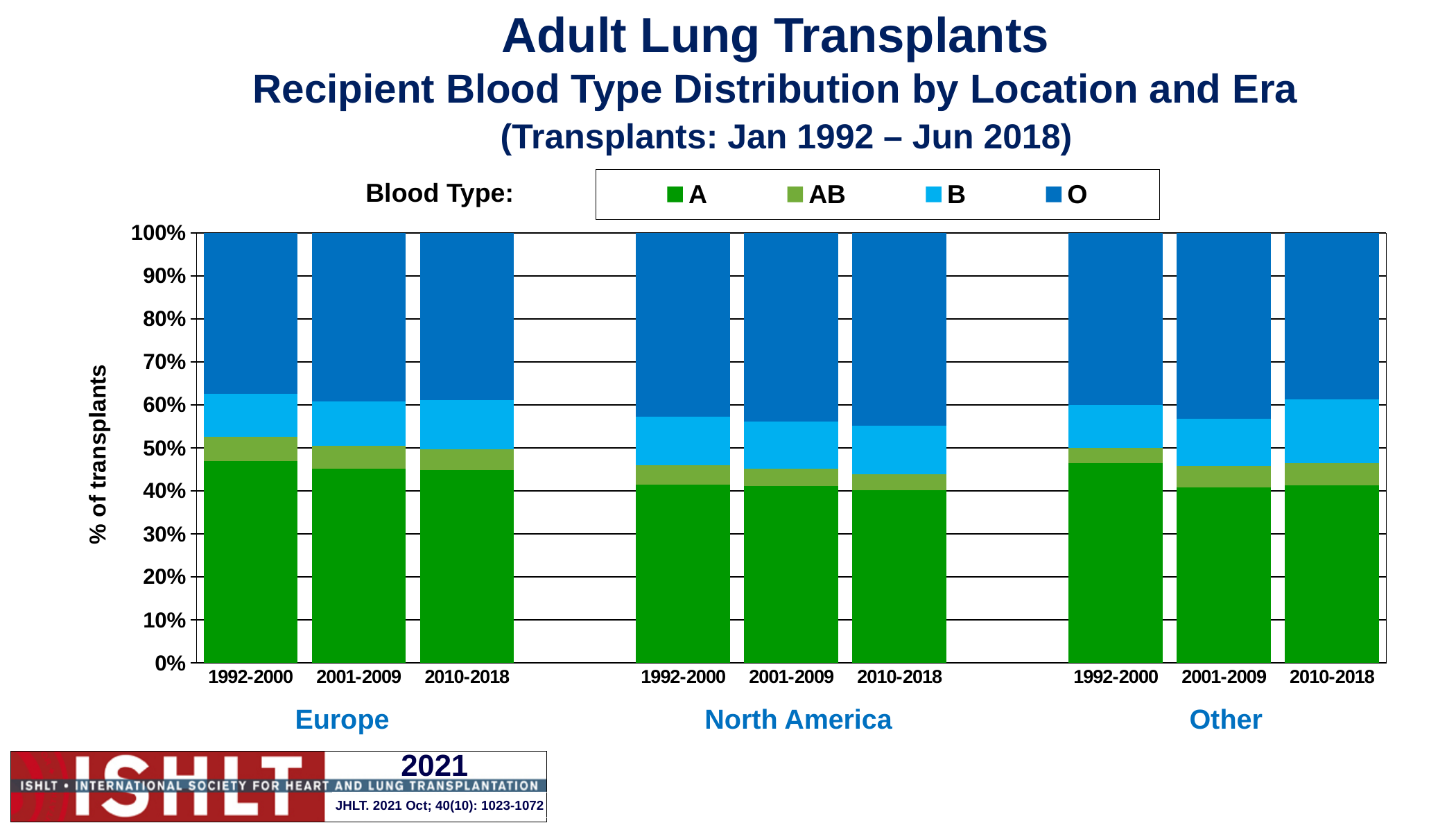
What kind of chart is shown on the slide? Stacked bar chart What is the total of each stacked bar in the chart? 100% For the 1992-2000 era, which location has the larger share of blood type A recipients, Europe or North America? Europe Is the share of blood type A recipients in Other for 2001-2009 greater or less than 50%? less Which bar has the larger blood type O share, North America 2010-2018 or Europe 1992-2000? North America 2010-2018 Does the share of blood type A recipients in Europe rise or fall across the three eras from 1992-2000 to 2010-2018? fall Which blood type is shown in dark blue in the legend? O Is the share of blood type A recipients in North America for 2010-2018 greater or less than 50%? less How many locations are shown along the x axis? 3 Is the share of blood type A recipients in Europe for 1992-2000 greater or less than 40%? greater How many stacked bars are plotted in the chart? 9 How many blood type series does the legend list? 4